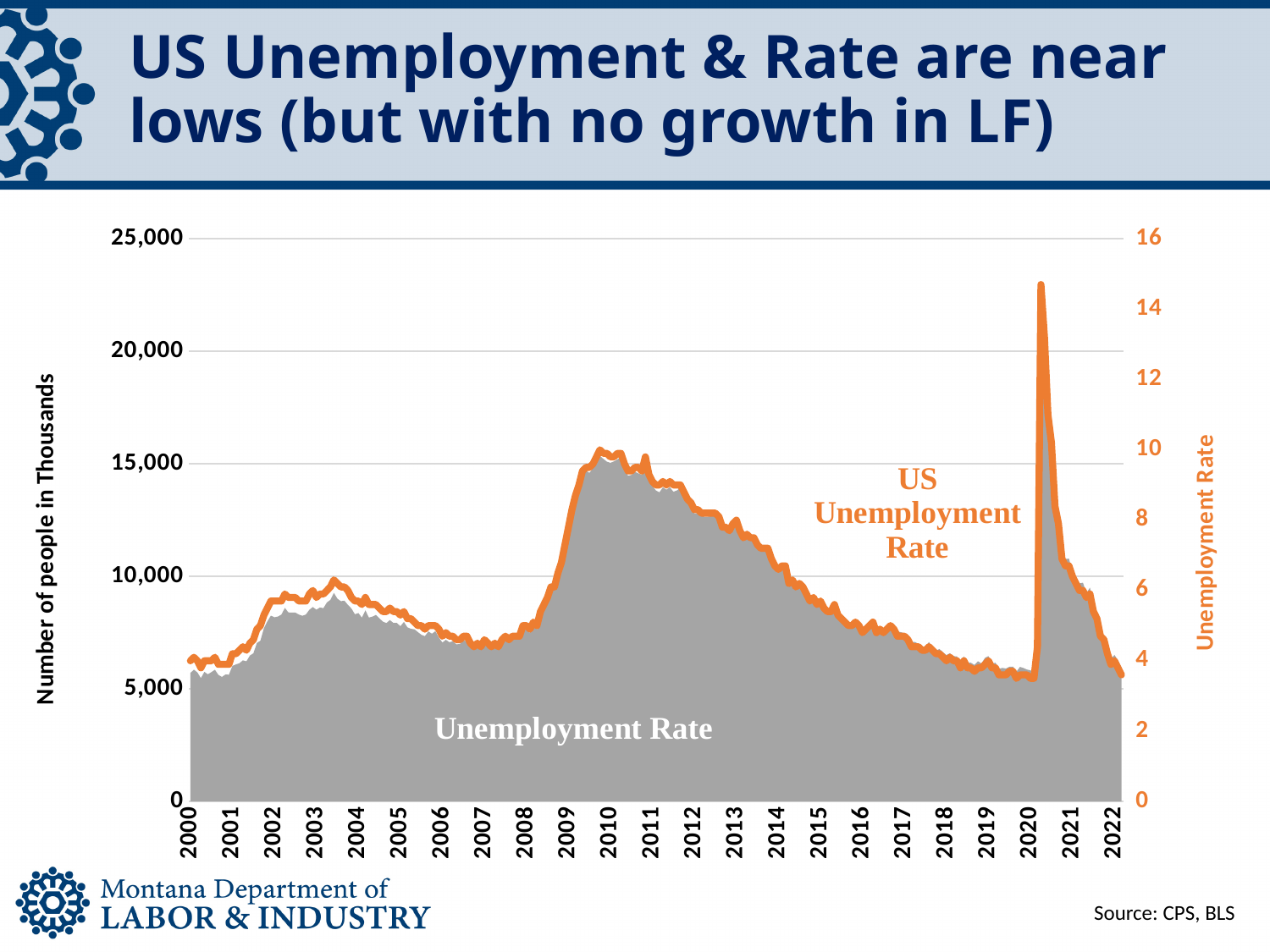
What kind of chart is shown on the slide? A combination area and line chart How many year labels are shown along the x axis? 23 Is the peak value of the US Unemployment Rate line in 2020 greater or less than 14 on the right axis? greater Is the gray area value (number of people in thousands) around 2010 greater or less than 10,000? greater How many data series are plotted on the chart? 2 Does the US Unemployment Rate line rise or fall between 2010 and 2019? fall Does the US Unemployment Rate line rise or fall between 2008 and 2010? rise What is the title of the left vertical axis? Number of people in Thousands Is the US Unemployment Rate around 2010 greater or less than 8 on the right axis? greater In which year does the US Unemployment Rate line reach its highest peak? 2020